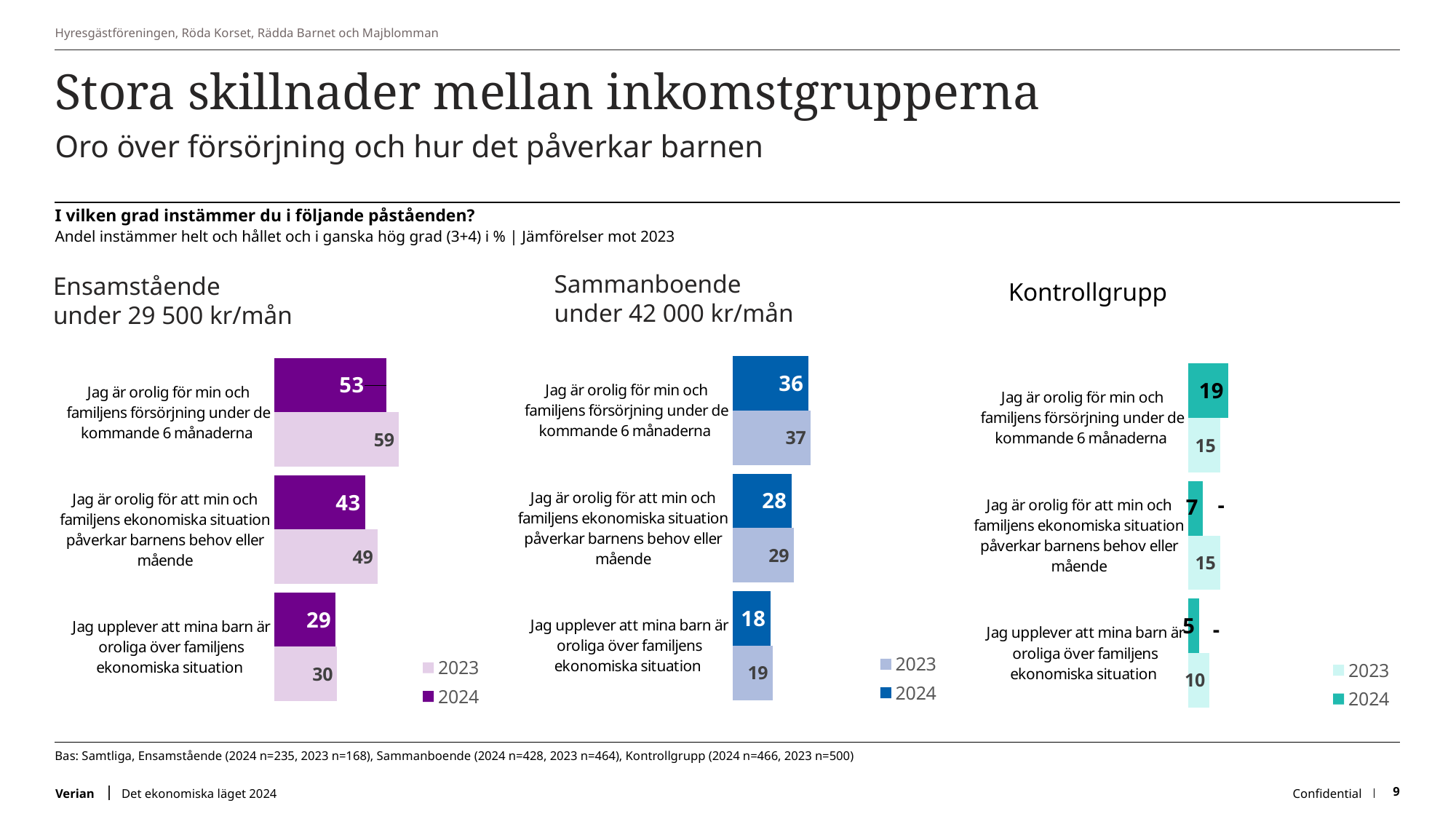
In the 'Kontrollgrupp' chart, what is the difference between the 2024 and 2023 values for 'Jag är orolig för min och familjens försörjning under de kommande 6 månaderna'? 4 In the 'Kontrollgrupp' chart, for 'Jag upplever att mina barn är oroliga över familjens ekonomiska situation', which year has the larger value, 2023 or 2024? 2023 In the 'Sammanboende under 42 000 kr/mån' chart, which statement has the lowest 2023 value? Jag upplever att mina barn är oroliga över familjens ekonomiska situation In the 'Ensamstående under 29 500 kr/mån' chart, which statement has the highest 2024 value? Jag är orolig för min och familjens försörjning under de kommande 6 månaderna What type of chart is the 'Kontrollgrupp' chart? Bar chart How many statements (categories) are shown in the 'Sammanboende under 42 000 kr/mån' chart? 3 In the 'Ensamstående under 29 500 kr/mån' chart, what is the 2023 value for 'Jag är orolig för att min och familjens ekonomiska situation påverkar barnens behov eller mående'? 49 How many series does the legend of the 'Ensamstående under 29 500 kr/mån' chart list? 2 In the 'Ensamstående under 29 500 kr/mån' chart, what is the difference between the 2023 and 2024 values for 'Jag är orolig för min och familjens försörjning under de kommande 6 månaderna'? 6 In the 'Ensamstående under 29 500 kr/mån' chart, what is the 2024 value for 'Jag är orolig för min och familjens försörjning under de kommande 6 månaderna'? 53 In the 'Sammanboende under 42 000 kr/mån' chart, what is the 2024 value for 'Jag upplever att mina barn är oroliga över familjens ekonomiska situation'? 18 In the 'Kontrollgrupp' chart, what is the 2023 value for 'Jag är orolig för min och familjens försörjning under de kommande 6 månaderna'? 15